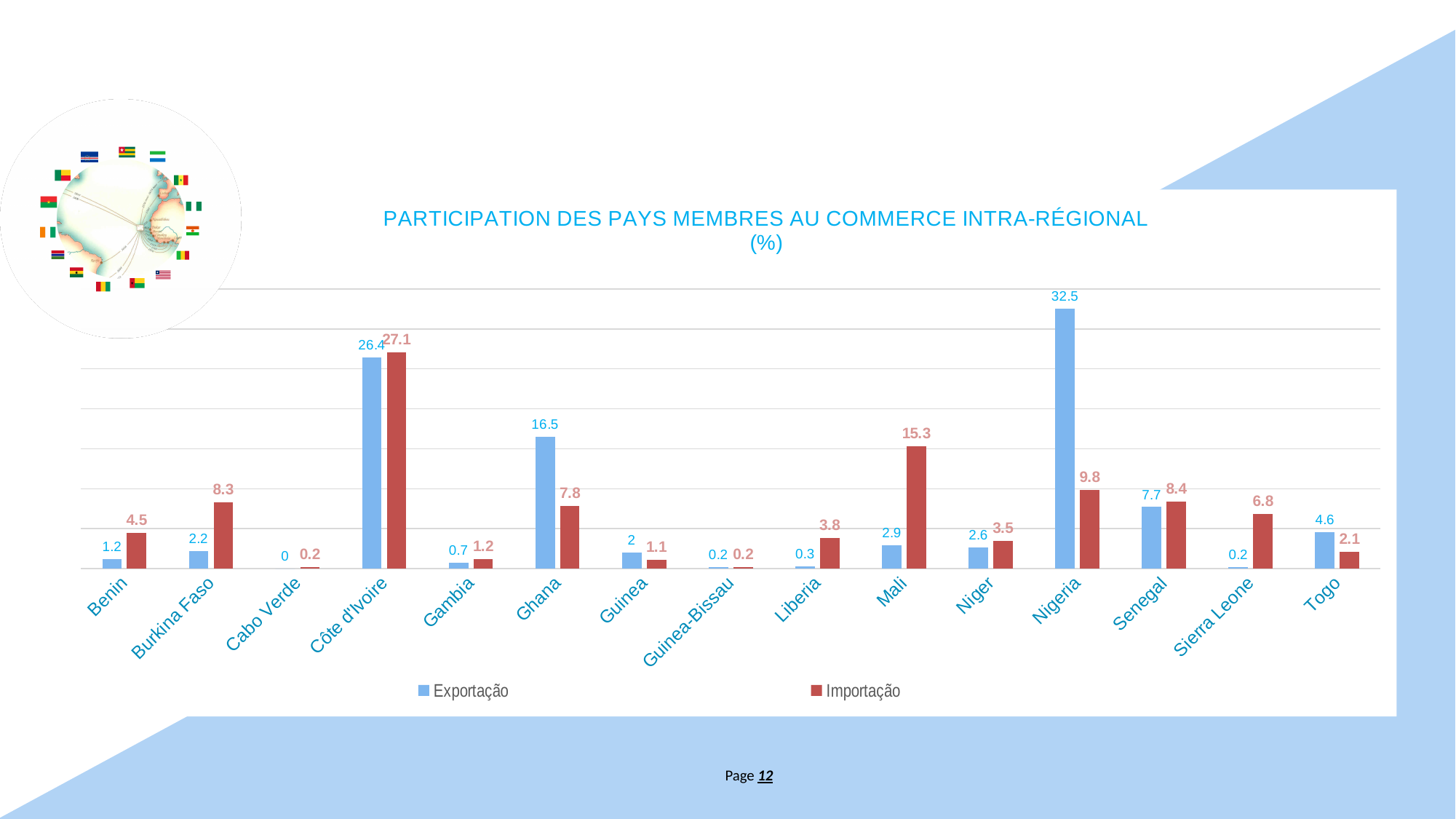
How many countries are shown on the x axis? 15 What is the Importação value for Mali? 15.3 Which country has the highest Importação value? Côte d'Ivoire Which is larger for Senegal, Exportação or Importação? Importação What is the Exportação value for Ghana? 16.5 How many series does the legend list? 2 What is the Importação value for Côte d'Ivoire? 27.1 Which country has the highest Exportação value? Nigeria What is the Exportação value for Nigeria? 32.5 What kind of chart is shown on the slide? Bar chart What is the difference between the Exportação and Importação values for Nigeria? 22.7 Which country has the lowest Exportação value? Cabo Verde